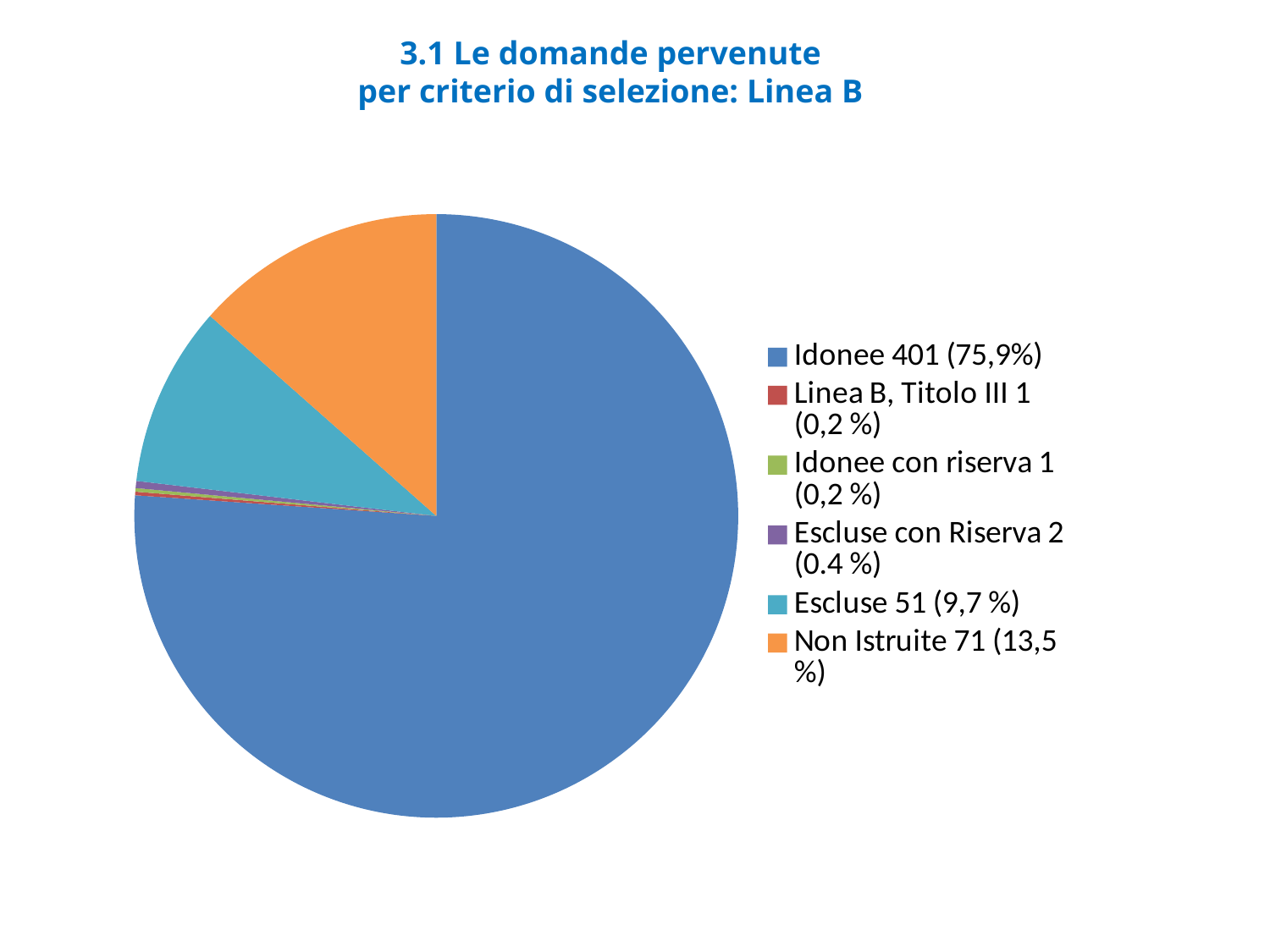
What is the difference between the values for Idonee and Escluse? 350 What share of the pie does Idonee represent? 75,9% What is the value for Idonee? 401 What share of the pie does Non Istruite represent? 13,5 % Which category has the largest slice of the pie? Idonee What is the value for Non Istruite? 71 What is the title of the chart? 3.1 Le domande pervenute per criterio di selezione: Linea B What is the value for Escluse? 51 How many categories does the pie chart show? 6 What kind of chart is shown on the slide? pie chart Which is larger, the value for Non Istruite or the value for Escluse? Non Istruite What is the value for Escluse con Riserva? 2